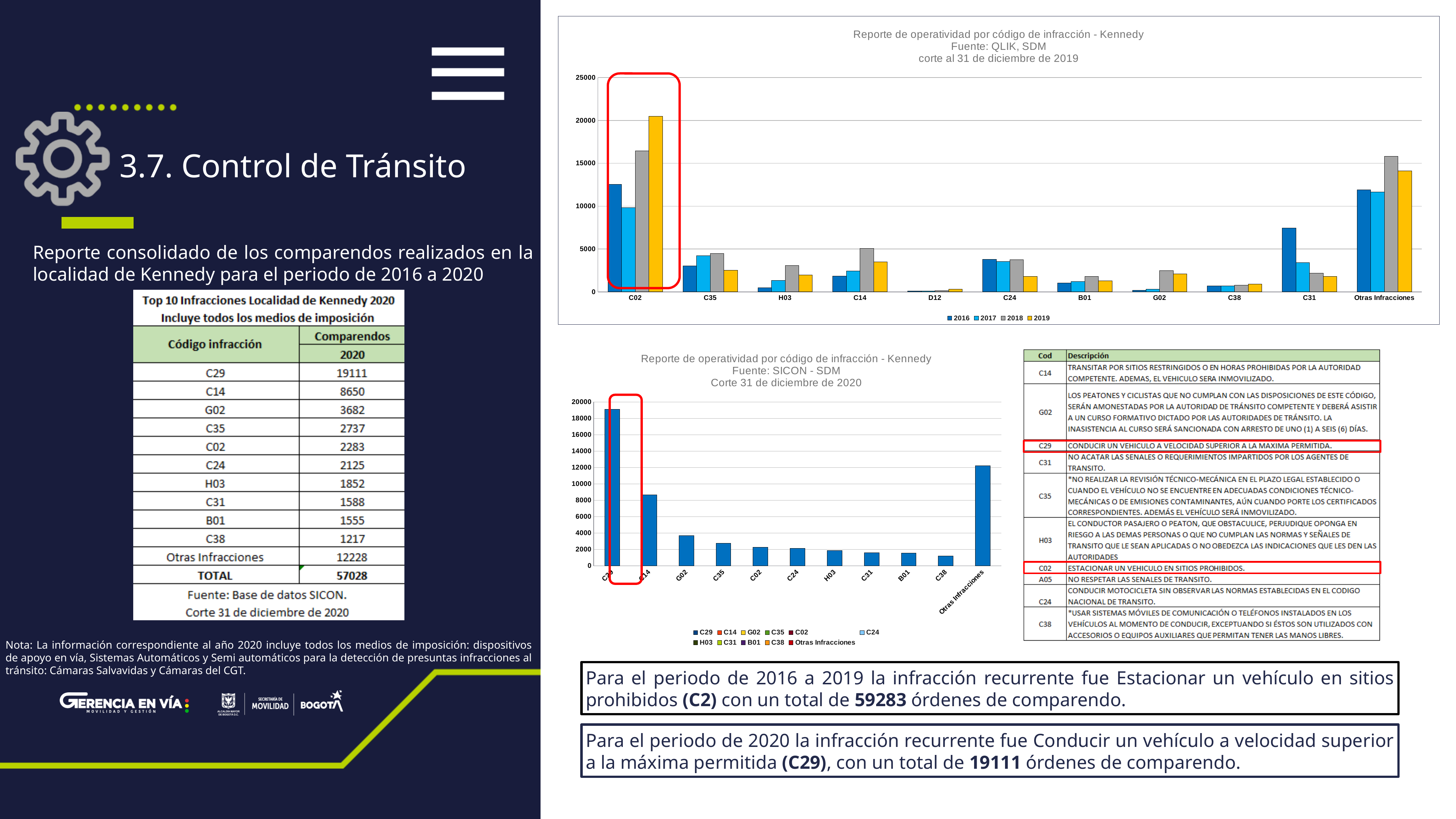
In the bottom chart (Corte 31 de diciembre de 2020), which infraction code has the lowest bar? C38 In the top chart (corte al 31 de diciembre de 2019), how many infraction categories are shown on the x axis? 11 In the top chart (corte al 31 de diciembre de 2019), how many series does the legend list? 4 In the bottom chart (Corte 31 de diciembre de 2020), how many entries does the legend list? 11 In the top chart (corte al 31 de diciembre de 2019), which infraction code has the lowest bars across all years? D12 In the top chart (corte al 31 de diciembre de 2019), is the 2019 value for C02 greater or less than 20000? greater In the top chart (corte al 31 de diciembre de 2019), is the 2018 value for C35 greater or less than 5000? less In the bottom chart (Corte 31 de diciembre de 2020), is the value for C14 greater or less than 10000? less In the top chart (corte al 31 de diciembre de 2019), which infraction code has the tallest bar for 2019? C02 In the bottom chart (Fuente: SICON - SDM, Corte 31 de diciembre de 2020), which infraction code has the highest bar? C29 What kind of chart is the top chart (Fuente: QLIK, SDM, corte al 31 de diciembre de 2019)? Bar chart In the top chart (corte al 31 de diciembre de 2019), which is larger for C02: the 2016 value or the 2019 value? 2019